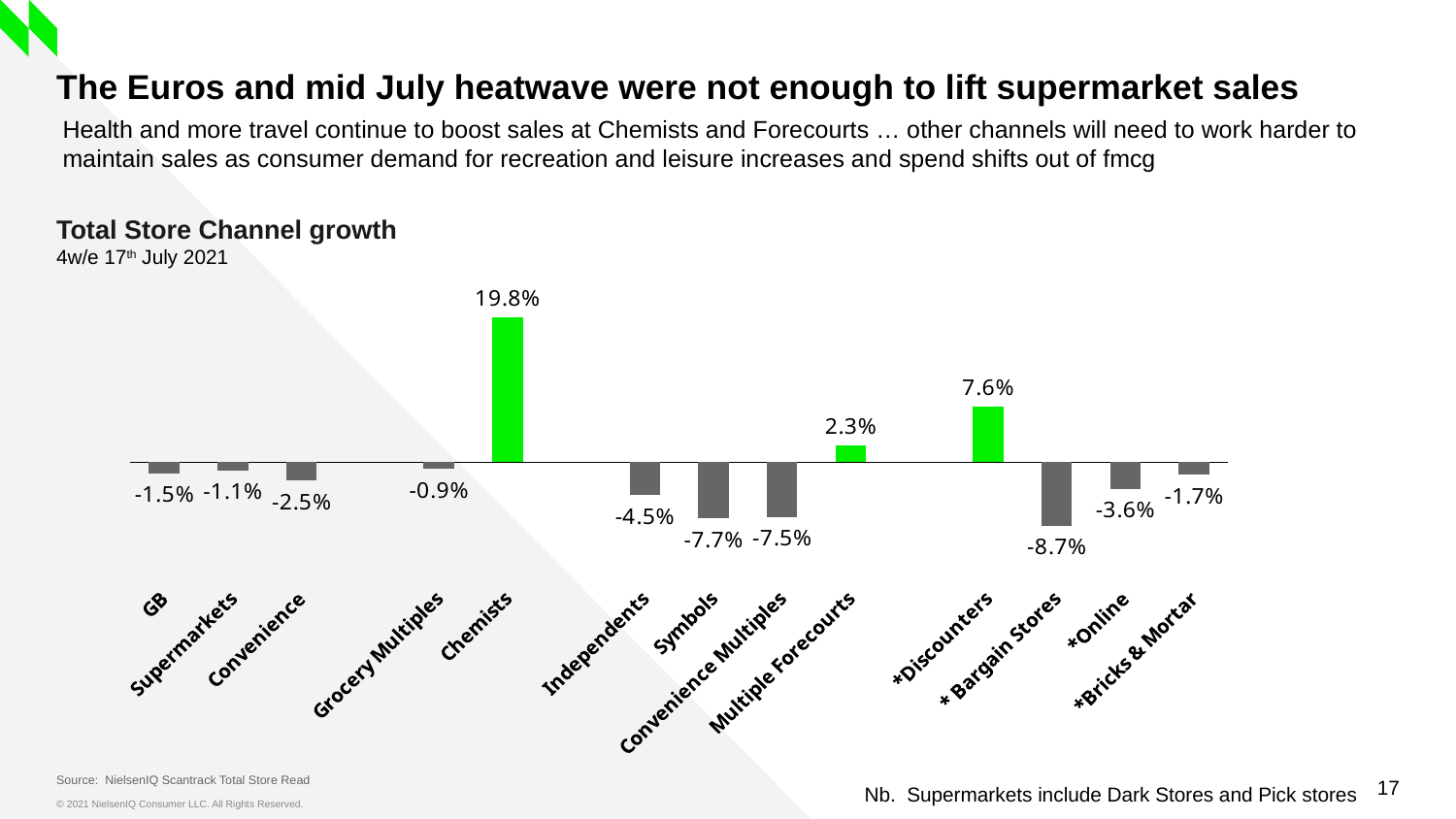
What is the growth value shown for Chemists? 19.8% What is the title of the chart? Total Store Channel growth What is the growth value shown for Supermarkets? -1.1% Which channel has the lowest growth value? Bargain Stores What is the growth value shown for Multiple Forecourts? 2.3% What is the growth value shown for Online? -3.6% What is the growth value shown for Bargain Stores? -8.7% Which channel has the highest growth value? Chemists What kind of chart is shown on the slide? Bar chart Which has the larger growth value, Discounters or Multiple Forecourts? Discounters What is the difference between the growth values for Chemists and Discounters? 12.2 percentage points How many channels are plotted on the chart? 13